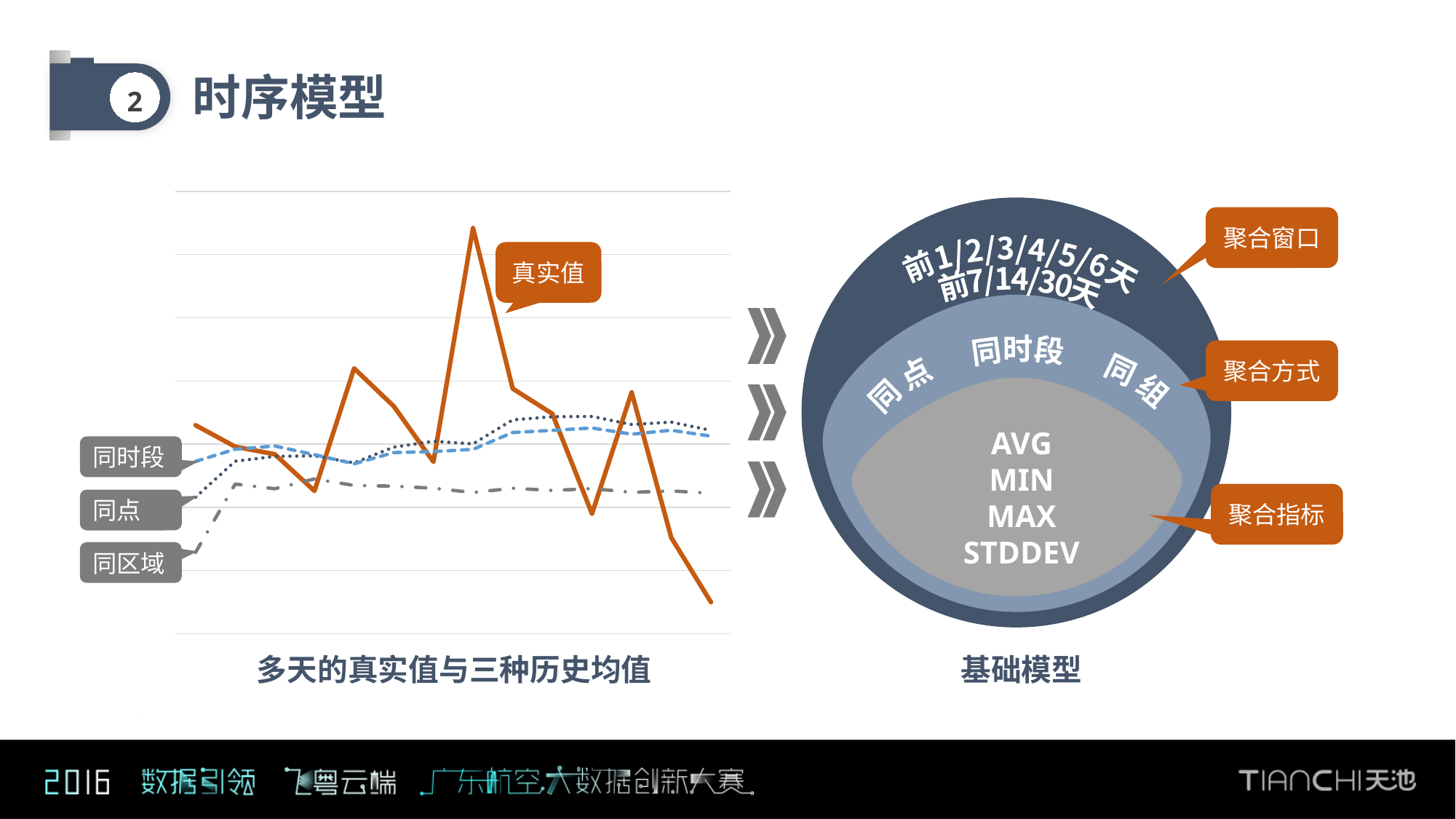
What is the caption under the line chart on the left? 多天的真实值与三种历史均值 In the line chart on the left, which series ends at the lowest point on the right edge? 真实值 In the line chart on the left, at the left edge of the chart, is 同时段 higher or lower than 同点? higher How many labelled series are plotted in the line chart on the left? 4 In the line chart on the left, at the right end of the chart, is 真实值 higher or lower than 同时段? lower What kind of chart is shown on the left side of the slide? line chart In the line chart on the left, does the 真实值 series end higher or lower than where it starts? lower In the line chart on the left, which series shows the largest fluctuations? 真实值 In the line chart on the left, which series reaches the highest peak? 真实值 In the line chart on the left, which series starts at the lowest point on the left edge? 同区域